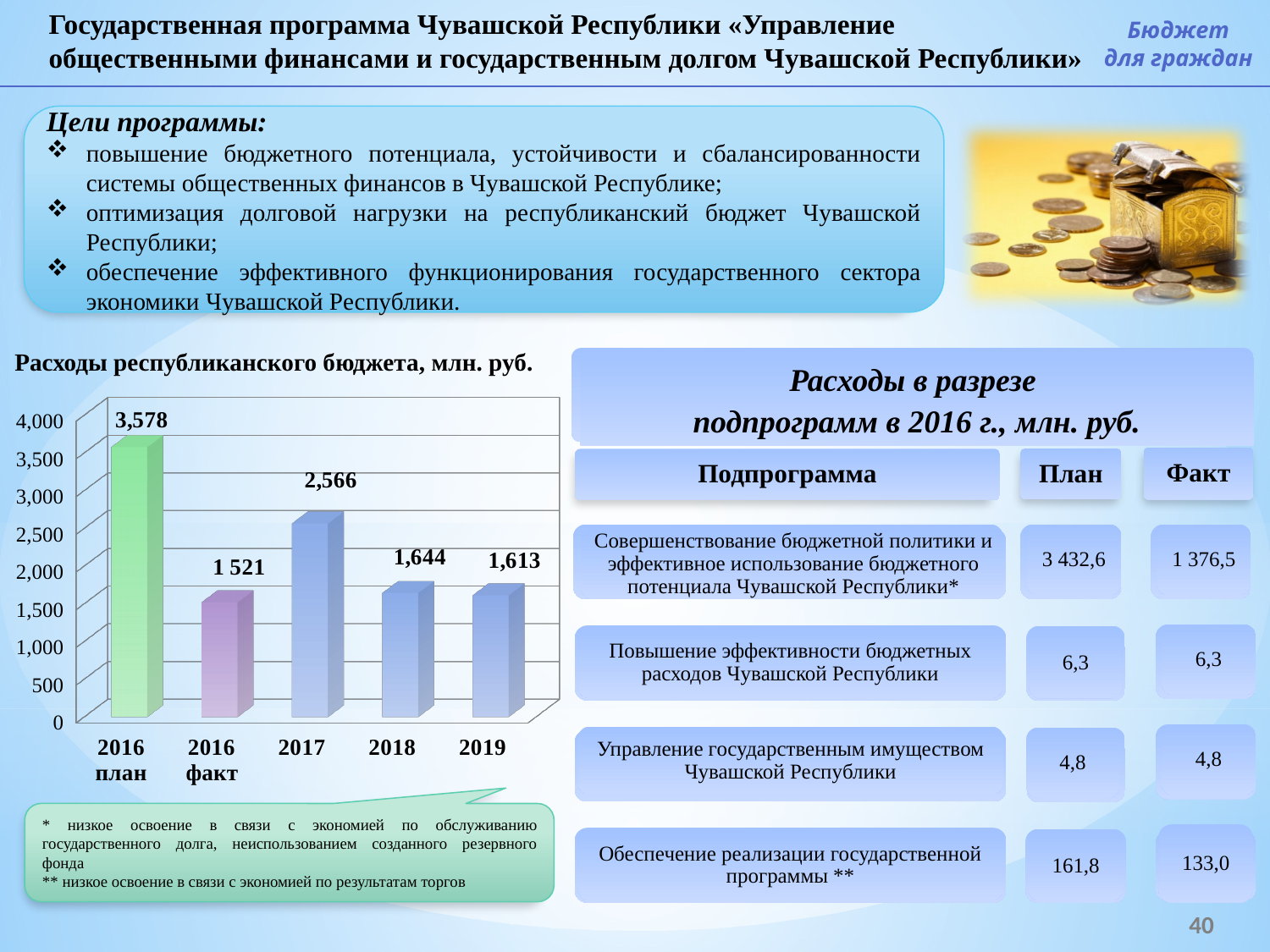
Which is larger, the value for 2017 or the value for 2018? 2017 What is the value for 2018 in the chart? 1,644 Which category has the highest value in the chart? 2016 план What is the difference between the values for 2016 план and 2016 факт? 2,057 What type of chart is shown on the slide? bar chart What is the value for 2016 факт in the chart? 1 521 Which category has the lowest value in the chart? 2016 факт What is the value for 2017 in the chart? 2,566 What is the value for 2019 in the chart? 1,613 What is the value for 2016 план in the chart? 3,578 How many bars are shown in the chart? 5 What is the title of the chart? Расходы республиканского бюджета, млн. руб.